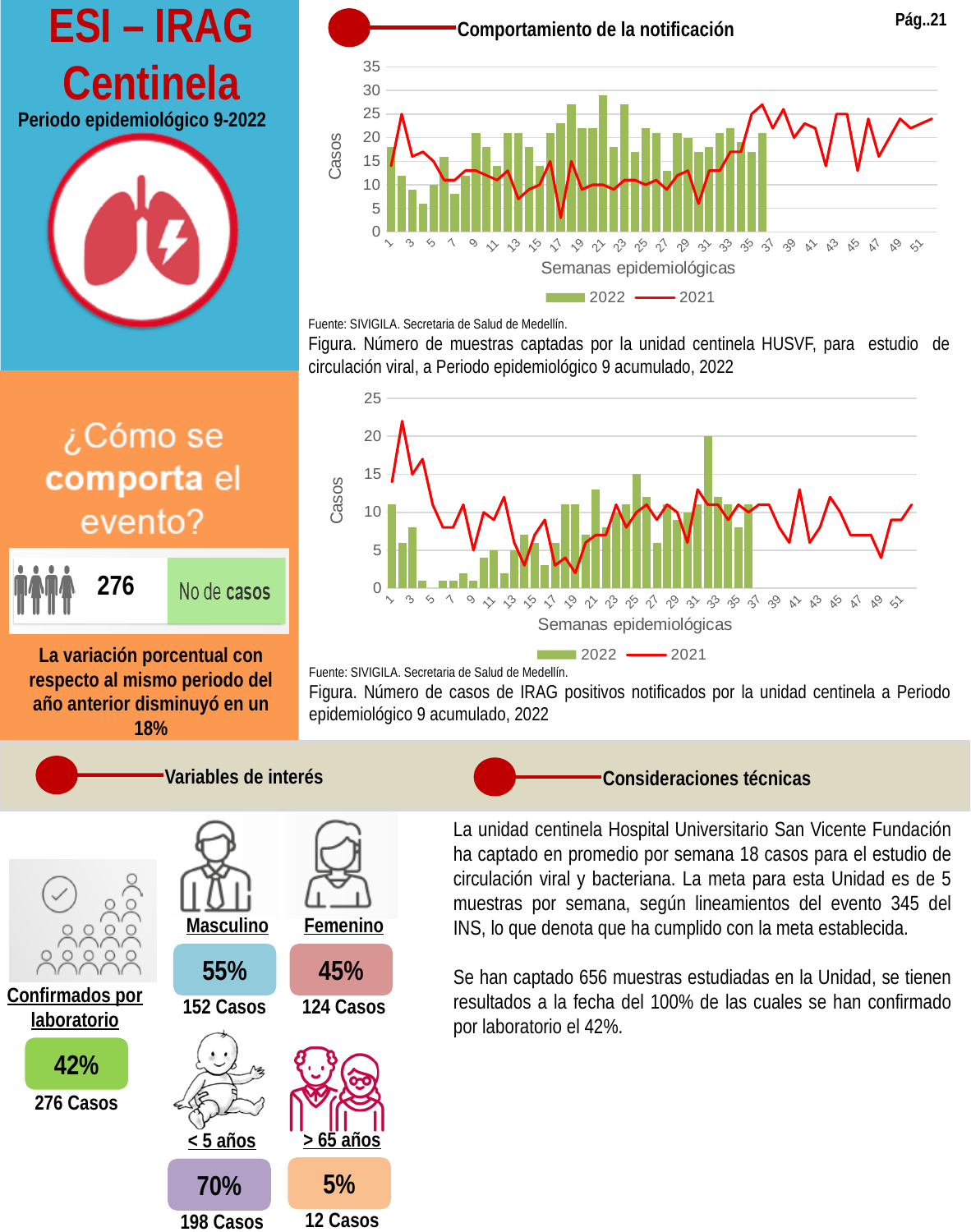
In the bottom chart (Número de casos de IRAG positivos notificados), is the 2021 line value at week 2 greater or less than 20? greater In the bottom chart (Número de casos de IRAG positivos notificados), is the 2022 bar for week 5 greater or less than 5? less In the top chart (Número de muestras captadas por la unidad centinela HUSVF), how many series does the legend list? 2 In the bottom chart (Número de casos de IRAG positivos notificados), what is the label of the x axis? Semanas epidemiológicas In the top chart (Número de muestras captadas por la unidad centinela HUSVF), is the 2021 line value at week 2 greater or less than 20? greater In the top chart (Número de muestras captadas por la unidad centinela HUSVF), which series is drawn as bars and which as a line? 2022 as bars, 2021 as a line In the top chart (Número de muestras captadas por la unidad centinela HUSVF), which 2022 bar is larger, week 3 or week 17? week 17 In the bottom chart (Número de casos de IRAG positivos notificados), which week has the highest 2022 bar? Week 32 In the bottom chart (Número de casos de IRAG positivos notificados), what kind of chart is it? Combined bar and line chart